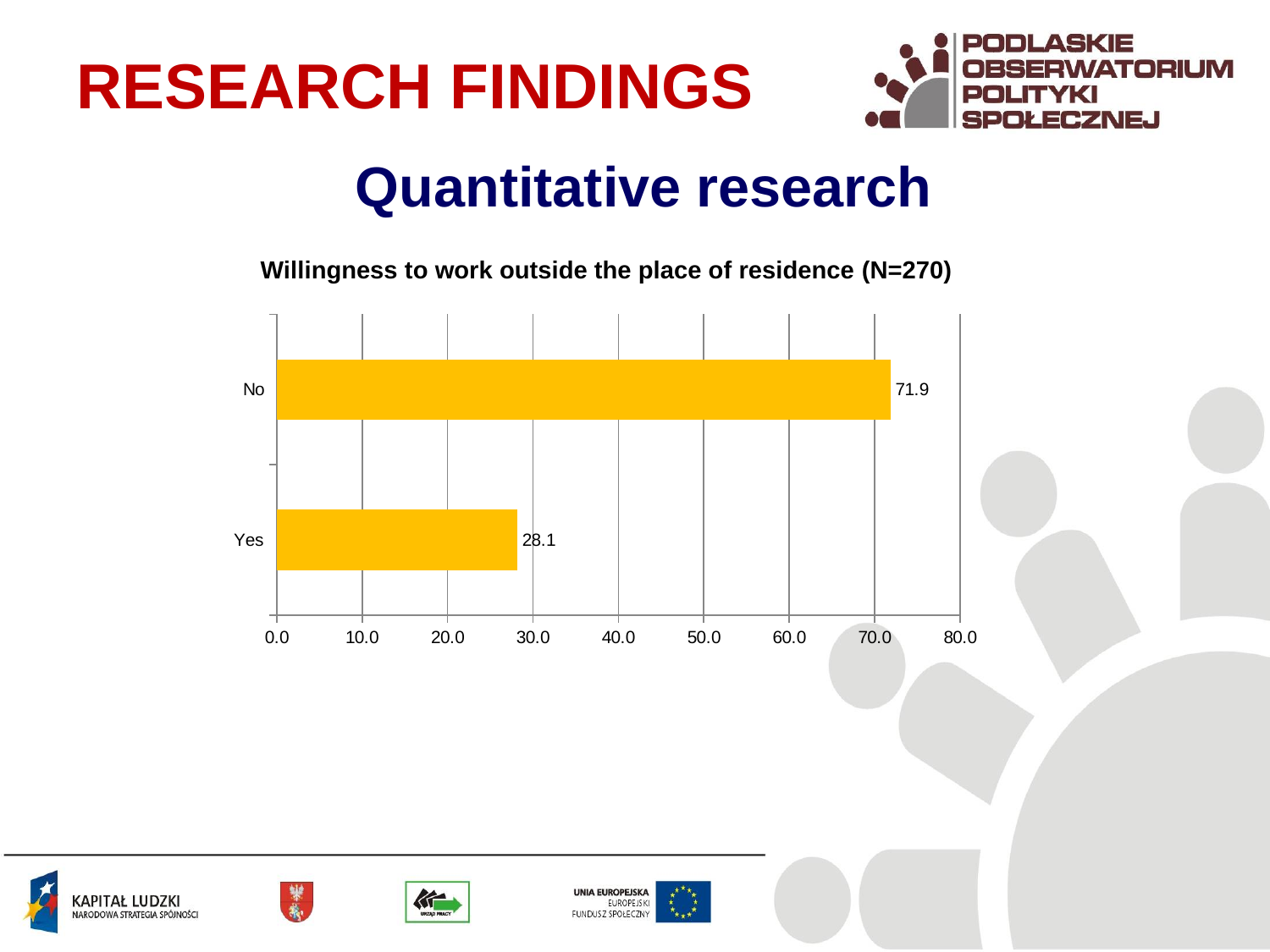
Which category has the highest value? No Is the value for "No" greater or less than 70.0? greater What is the value for "No" in the chart? 71.9 What is the maximum value shown on the x axis of the chart? 80.0 What is the title of the chart? Willingness to work outside the place of residence (N=270) Which category has the lowest value? Yes How many categories are shown in the chart? 2 What is the difference between the values for "No" and "Yes"? 43.8 What kind of chart is shown on the slide? bar chart Is the value for "Yes" greater or less than 30.0? less Which is larger, the value for "Yes" or the value for "No"? No What is the value for "Yes" in the chart? 28.1